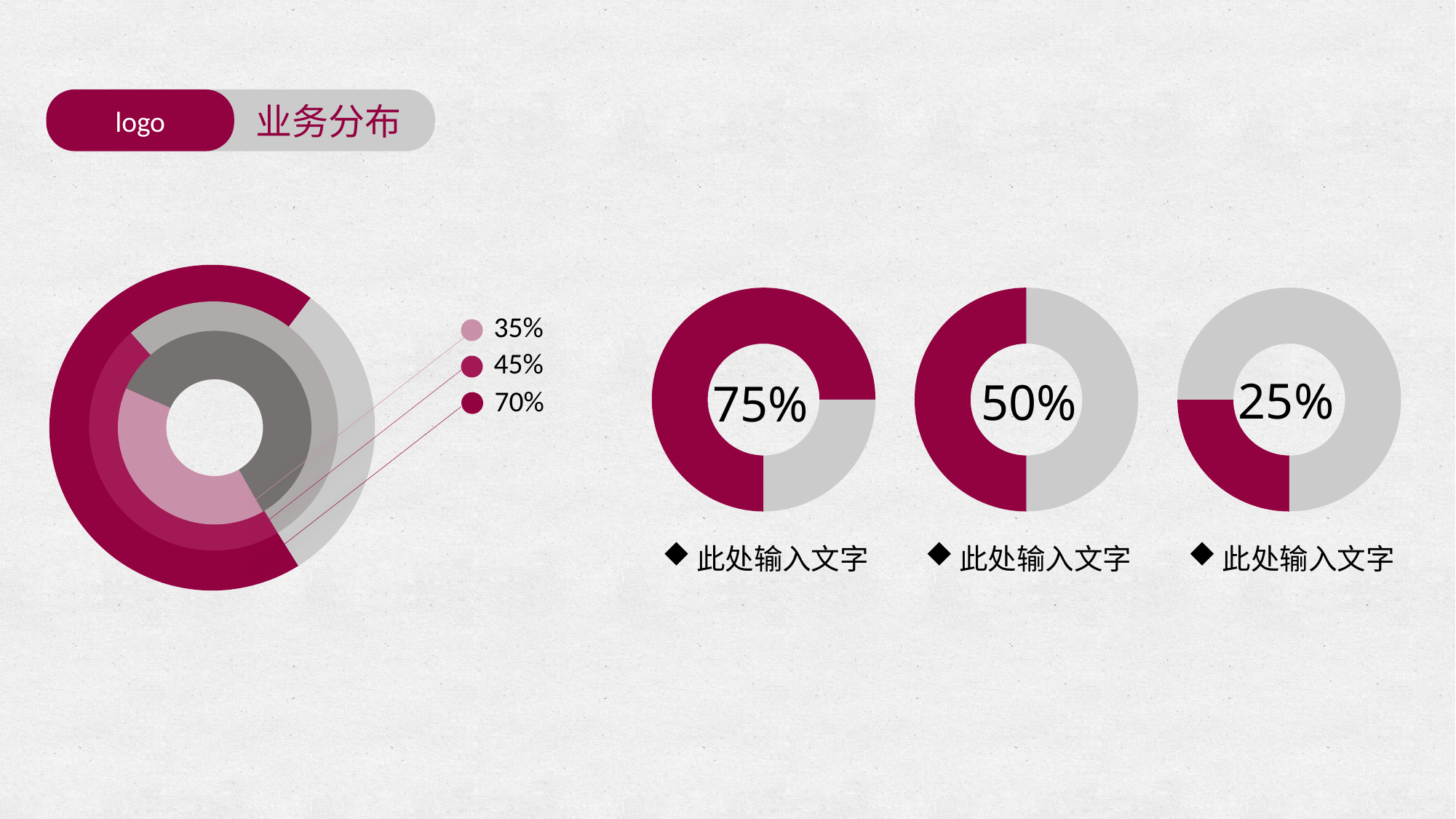
What percentage is shown in the centre of the rightmost doughnut chart on the slide? 25% What percentage is shown in the centre of the middle doughnut chart on the right side of the slide? 50% Among the three doughnut charts on the right side of the slide, which one shows the lowest percentage? The rightmost one (25%) Among the three doughnut charts on the right side of the slide, which one shows the highest percentage? The leftmost one (75%) What is the title shown at the top of the slide next to the logo? 业务分布 How many small doughnut charts are shown on the right side of the slide? 3 What percentage is shown in the centre of the leftmost of the three doughnut charts on the right side of the slide? 75% Which is larger: the percentage in the middle doughnut chart or the percentage in the rightmost doughnut chart on the right side of the slide? The middle doughnut chart (50%) What kind of chart is the large chart on the left side of the slide? A multi-ring doughnut chart What are the three percentages listed in the legend next to the large chart on the left side of the slide? 35%, 45%, 70% What is the difference between the percentage in the leftmost doughnut chart and the percentage in the rightmost doughnut chart on the right side of the slide? 50% How many entries does the legend next to the large chart on the left side of the slide list? 3